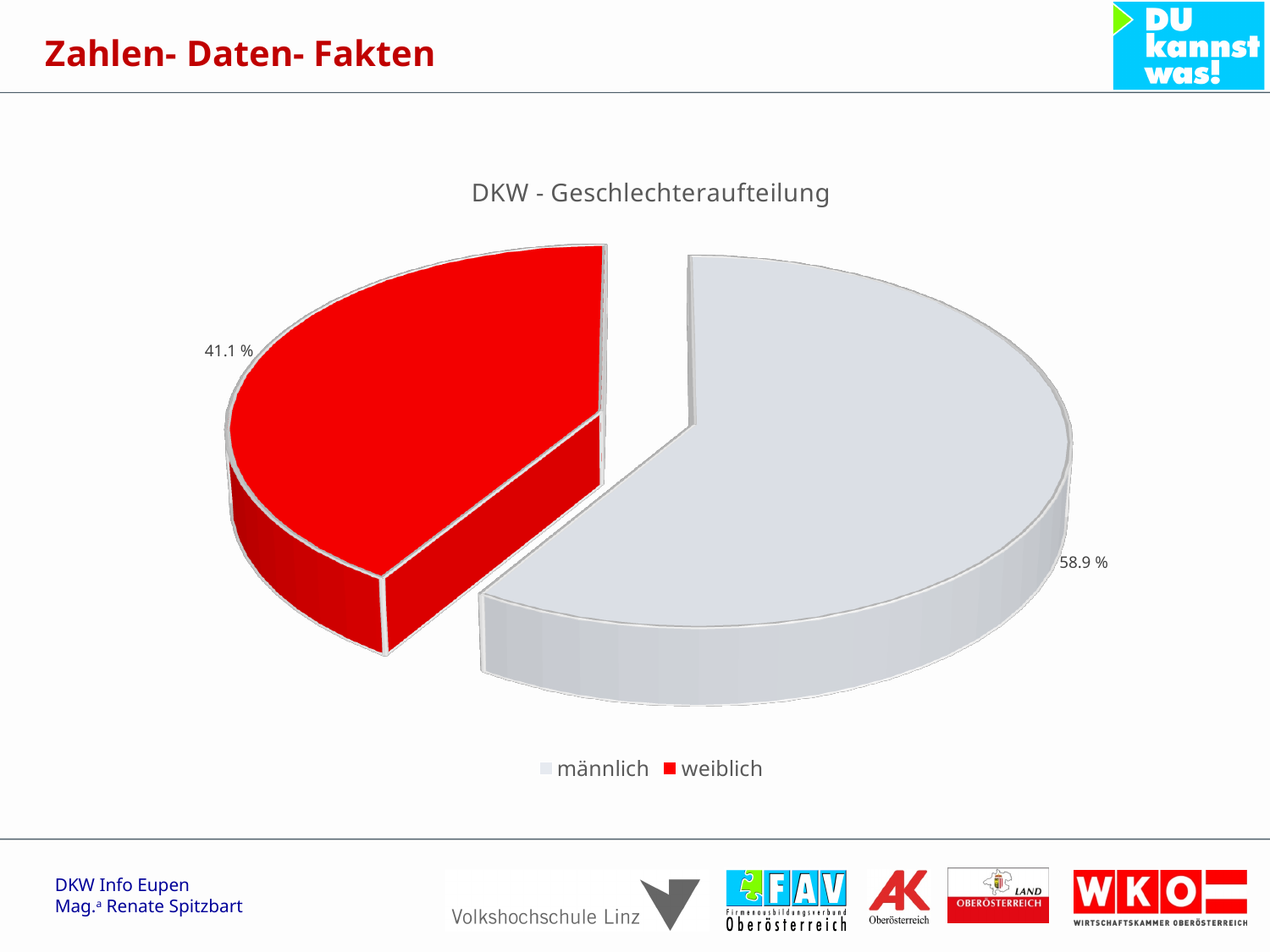
What colour is the weiblich slice? red Which category has the largest share of the pie? männlich What share of the pie is weiblich? 41.1 % What share of the pie is männlich? 58.9 % How many slices does the pie chart have? 2 How many entries does the legend list? 2 Which is larger, the share for männlich or the share for weiblich? männlich What is the difference in percentage points between the männlich and weiblich shares? 17.8 What kind of chart is shown on the slide? pie chart What is the title of the chart? DKW - Geschlechteraufteilung Which category has the smallest share of the pie? weiblich